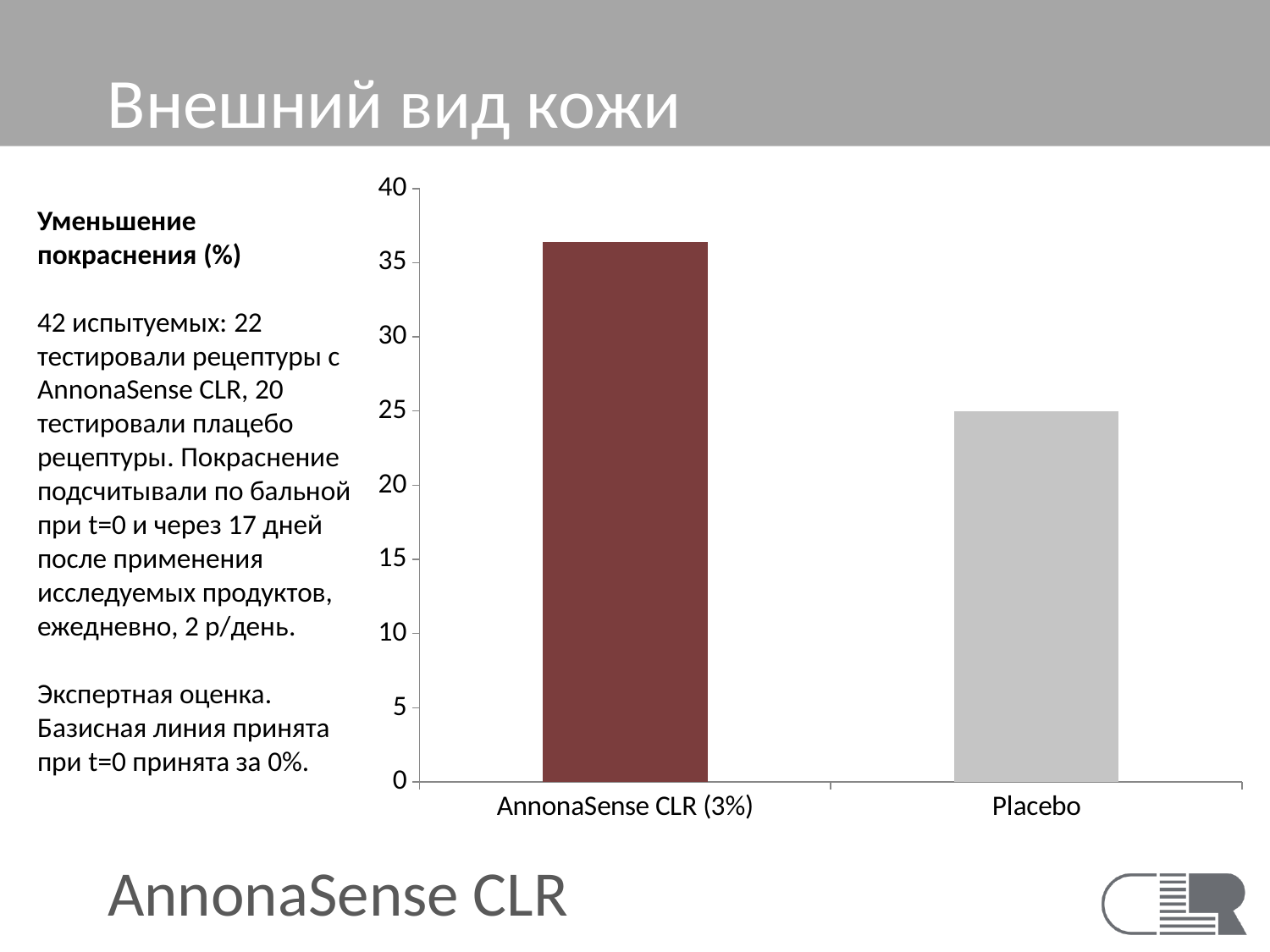
Is the value for AnnonaSense CLR (3%) greater or less than 35? greater Which category has the highest value in the chart? AnnonaSense CLR (3%) What kind of chart is shown on the slide? bar chart Is the value for AnnonaSense CLR (3%) greater or less than 40? less How many bars (categories) does the chart show? 2 Is the value for Placebo greater or less than 20? greater What is the title of the slide containing the chart? Внешний вид кожи What is the maximum value shown on the vertical axis of the chart? 40 What is the value for Placebo in the chart? 25 Which is larger, the value for AnnonaSense CLR (3%) or the value for Placebo? AnnonaSense CLR (3%) Which category has the lowest value in the chart? Placebo